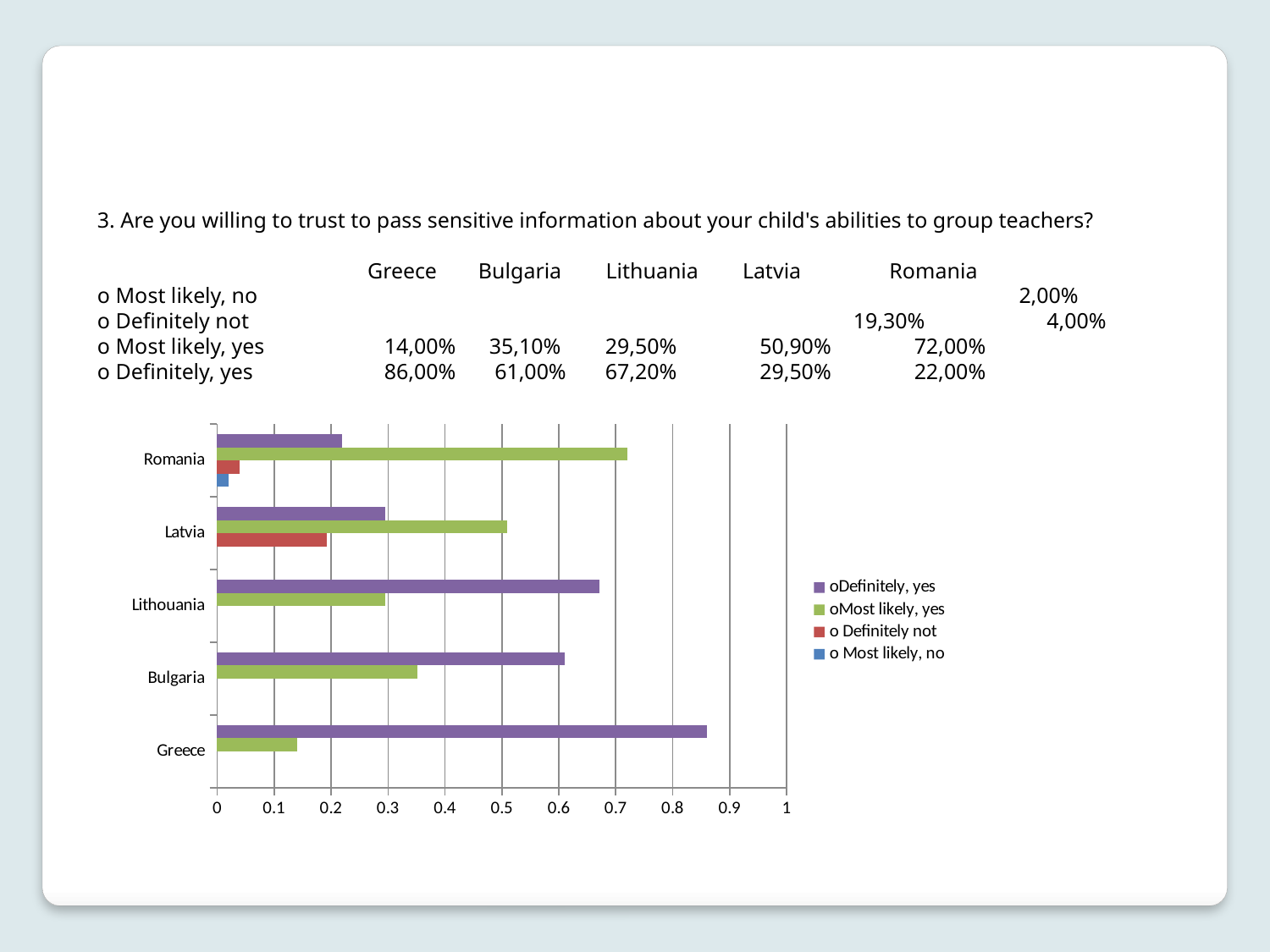
How many countries are shown on the chart's vertical axis? 5 Which is larger: the 'Definitely, yes' value for Bulgaria or for Lithuania? Lithuania Which country has the highest 'Most likely, yes' value in the chart? Romania According to the table above the chart, what is the 'Definitely, yes' value for Greece? 86,00% Is the 'Most likely, yes' value for Latvia greater or less than 0.4? greater How many series does the chart's legend list? 4 Which country has the highest 'Definitely, yes' value in the chart? Greece What kind of chart is shown on the slide? bar chart Which country is the only one with a 'Most likely, no' bar in the chart? Romania Is the 'Definitely, yes' value for Greece greater or less than 0.8? greater Is the 'Definitely, yes' value for Romania greater or less than 0.3? less Which country has the lowest 'Definitely, yes' value in the chart? Romania